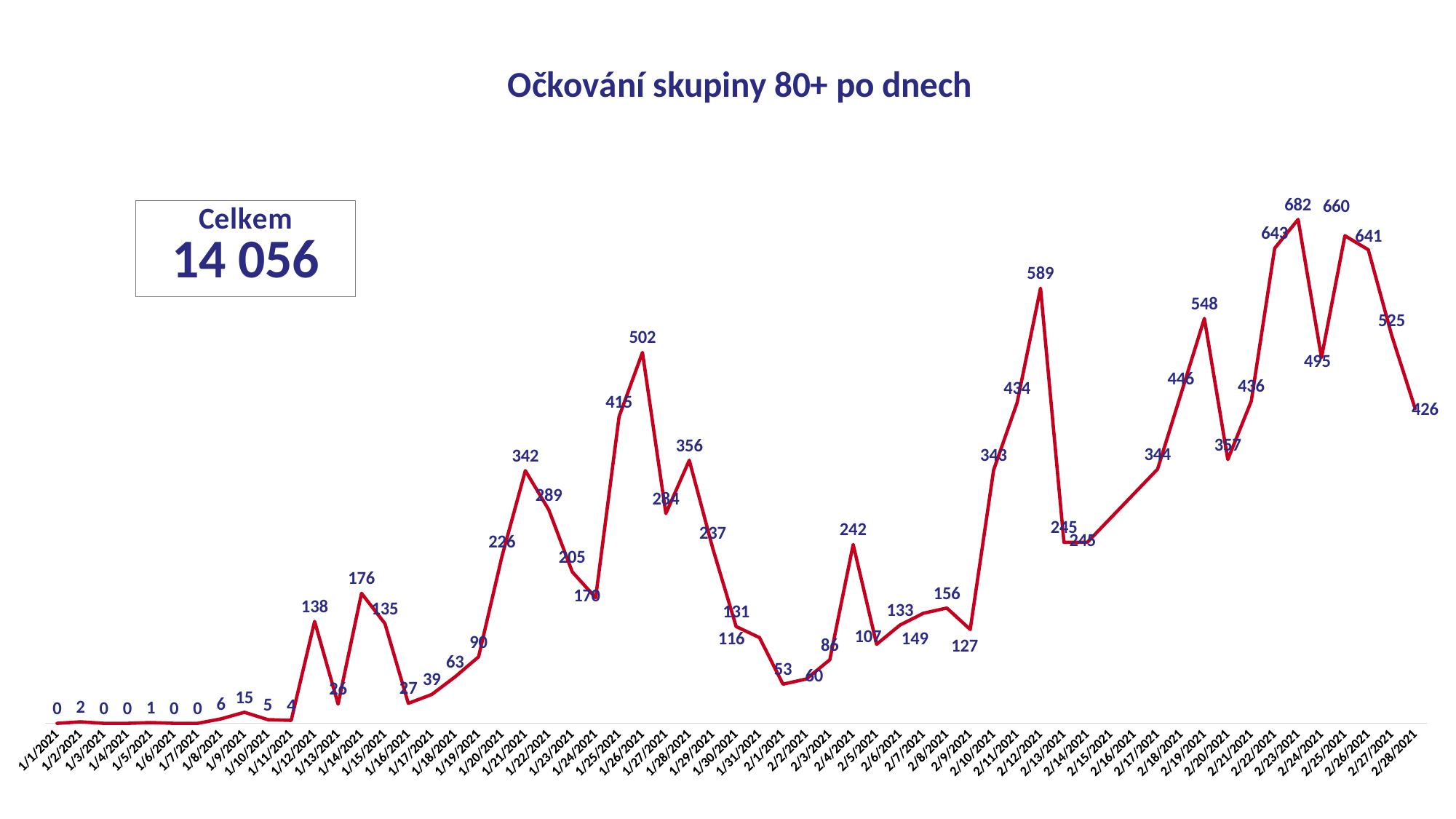
What is the highest value plotted on the chart? 682 What is the value for 1/21/2021? 342 What is the difference between the values for 2/23/2021 and 2/24/2021? 187 What is the value for 2/12/2021? 589 What is the value for 1/26/2021? 502 What is the title of the chart? Očkování skupiny 80+ po dnech Do the values rise or fall from 2/26/2021 to 2/28/2021? fall Which date has the larger value, 2/25/2021 or 2/26/2021? 2/25/2021 What is the value for 2/28/2021? 426 What kind of chart is shown on the slide? line chart What total value is shown in the 'Celkem' box on the slide? 14 056 On which date does the line reach its highest value? 2/23/2021